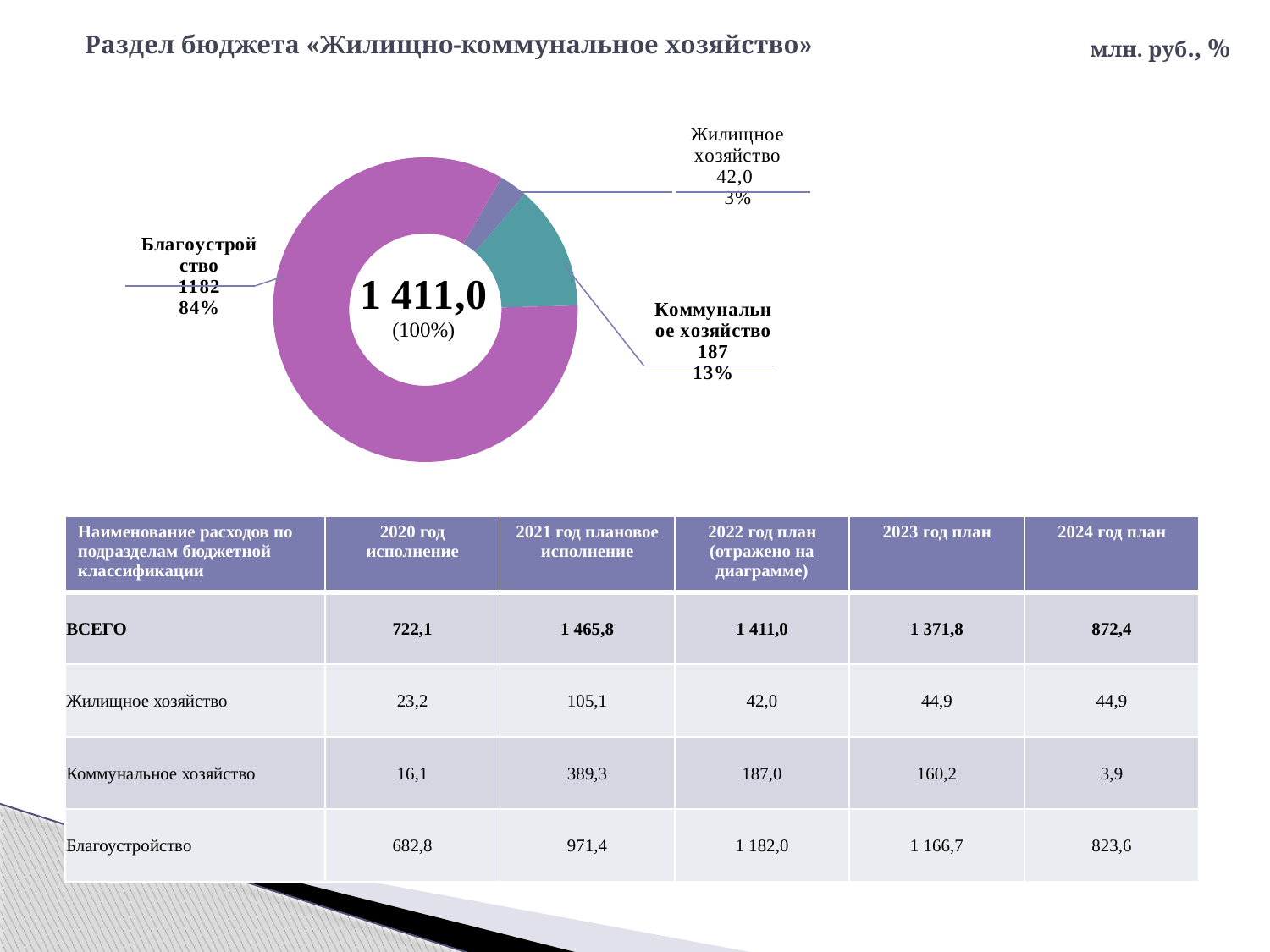
What share of the doughnut chart does Благоустройство represent? 84% Which category has the smallest slice of the doughnut chart? Жилищное хозяйство What total value is shown in the centre of the doughnut chart? 1 411,0 What value is shown for Жилищное хозяйство on the doughnut chart? 42,0 How many categories are shown on the doughnut chart? 3 Which is larger on the doughnut chart: Коммунальное хозяйство or Жилищное хозяйство? Коммунальное хозяйство What share of the doughnut chart does Коммунальное хозяйство represent? 13% What share of the doughnut chart does Жилищное хозяйство represent? 3% What value is shown for Коммунальное хозяйство on the doughnut chart? 187 Which category has the largest slice of the doughnut chart? Благоустройство What is the difference between the values for Благоустройство and Коммунальное хозяйство on the doughnut chart? 995 What value is shown for Благоустройство on the doughnut chart? 1182